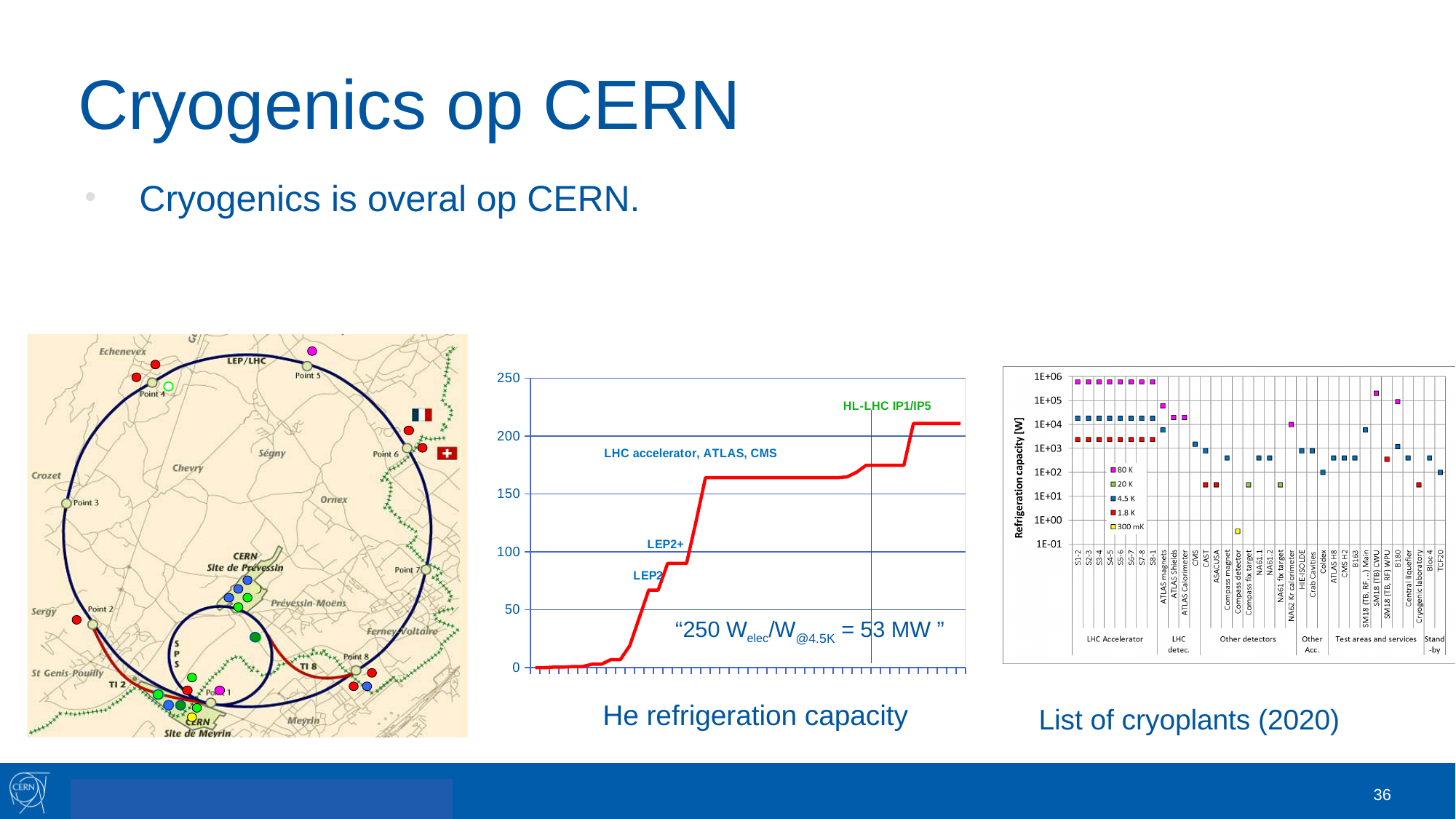
On the 'List of cryoplants (2020)' chart, what is the y-axis title? Refrigeration capacity [W] How many series does the legend of the 'List of cryoplants (2020)' chart list? 5 What kind of chart is the 'He refrigeration capacity' chart? line chart On the 'List of cryoplants (2020)' chart, is the 80 K value for S1-2 greater or less than 1E+05? greater On the 'List of cryoplants (2020)' chart, which is larger for S1-2: the 4.5 K value or the 1.8 K value? 4.5 K On the 'He refrigeration capacity' chart, is the plateau labelled 'LHC accelerator, ATLAS, CMS' greater or less than 150? greater On the 'He refrigeration capacity' chart, what is the highest value shown on the y axis? 250 On the 'He refrigeration capacity' chart, do the values rise or fall along the x axis? rise On the 'He refrigeration capacity' chart, is the value at the step labelled 'LEP2' greater or less than 100? less On the 'He refrigeration capacity' chart, which label marks the last step of the line? HL-LHC IP1/IP5